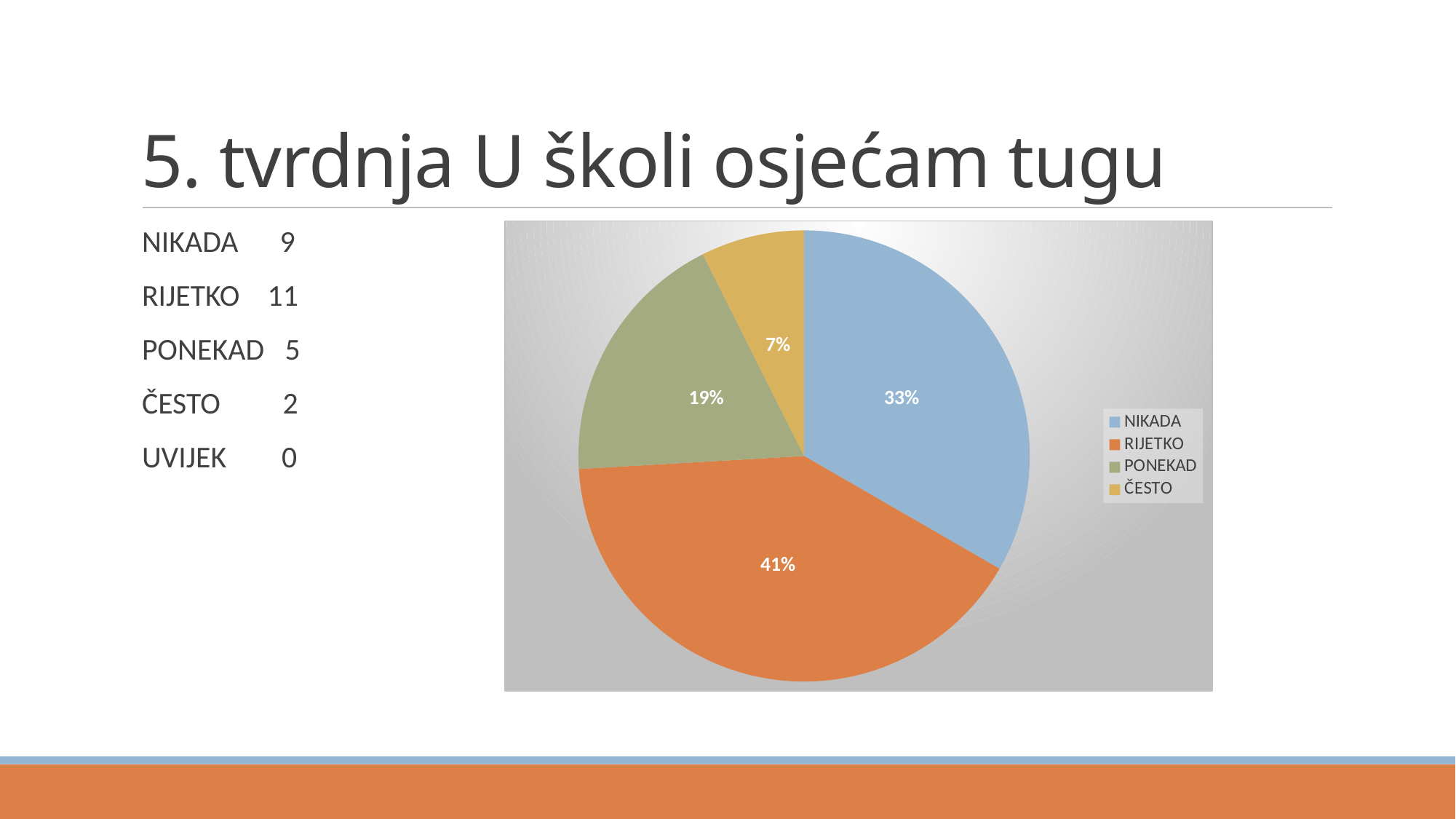
How many slices does the pie chart have? 4 What is the difference in percentage points between the RIJETKO slice and the NIKADA slice? 8 Which slice is larger, PONEKAD or ČESTO? PONEKAD Which category has the largest slice of the pie? RIJETKO Which category has the smallest slice of the pie? ČESTO How many entries does the legend list? 4 What percentage of the pie does the NIKADA slice represent? 33% What percentage of the pie does the PONEKAD slice represent? 19% What percentage of the pie does the ČESTO slice represent? 7% What colour is the RIJETKO slice? orange What kind of chart is shown on the slide? pie chart